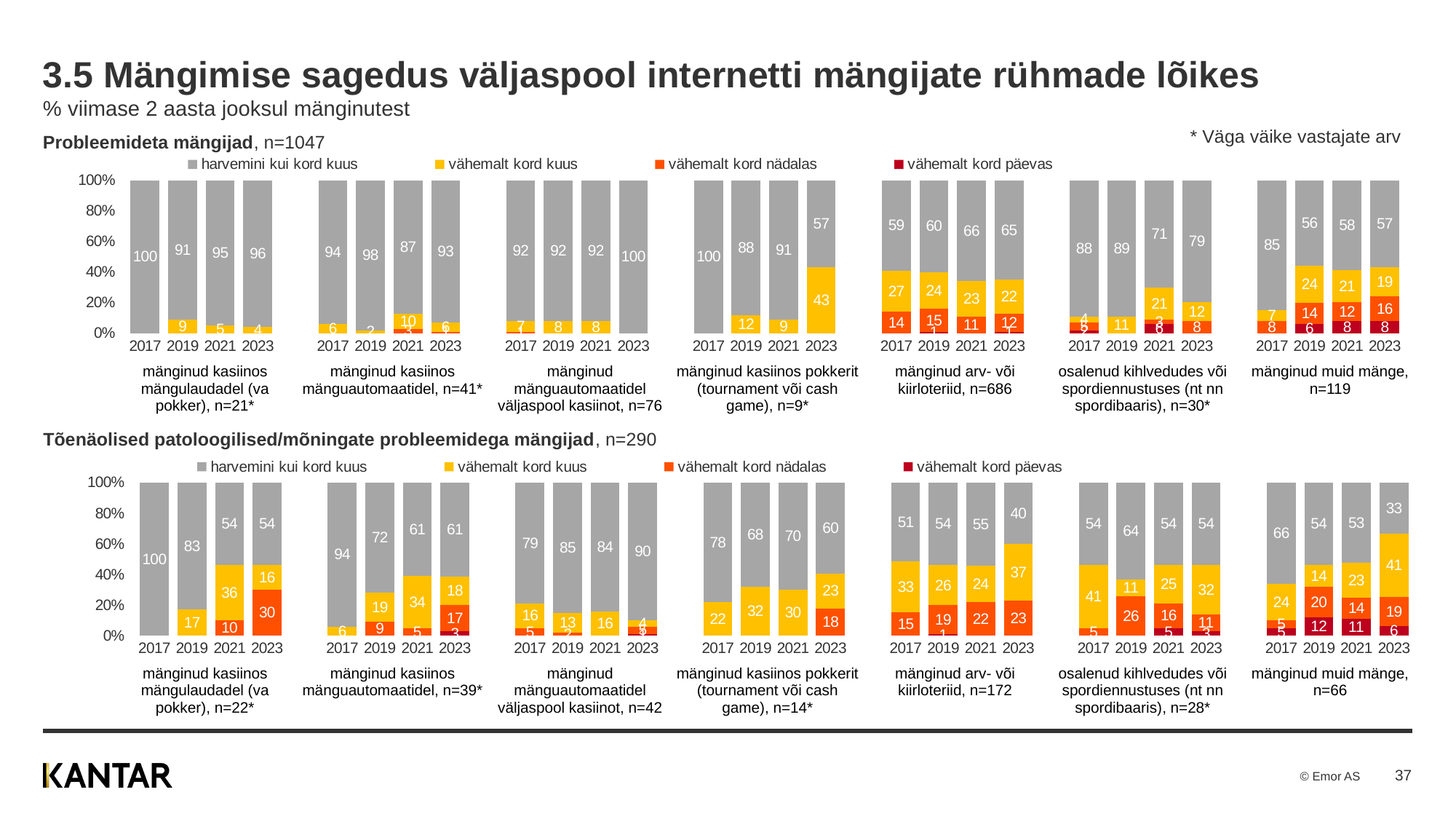
In the top chart (Probleemideta mängijad), what is the 'harvemini kui kord kuus' value for 'mänginud arv- või kiirloteriid' in 2017? 59 In the bottom chart, for 'mänginud kasiinos mängulaudadel' in 2023, which is larger: 'vähemalt kord nädalas' or 'vähemalt kord kuus'? vähemalt kord nädalas How many years are shown for each player group in the top chart? 4 In the bottom chart, what is the sample size (n) given for 'mänginud arv- või kiirloteriid'? n=172 In the top chart, for 'mänginud kasiinos pokkerit' in 2023, what is the difference between the 'harvemini kui kord kuus' value and the 'vähemalt kord kuus' value? 14 How many series does the legend of the top chart list? 4 In the bottom chart, what is the 'vähemalt kord nädalas' value for 'osalenud kihlvedudes või spordiennustuses' in 2019? 26 In the top chart, for 'mänginud muid mänge', which year has the highest 'harvemini kui kord kuus' value? 2017 In the bottom chart (Tõenäolised patoloogilised/mõningate probleemidega mängijad), what is the 'vähemalt kord kuus' value for 'mänginud kasiinos pokkerit' in 2023? 23 In the bottom chart, for 'mänginud arv- või kiirloteriid', which year has the lowest 'harvemini kui kord kuus' value? 2023 In the bottom chart, does the 'harvemini kui kord kuus' value for 'mänginud muid mänge' rise or fall from 2017 to 2023? Fall What kind of chart is used on this slide? Stacked bar chart